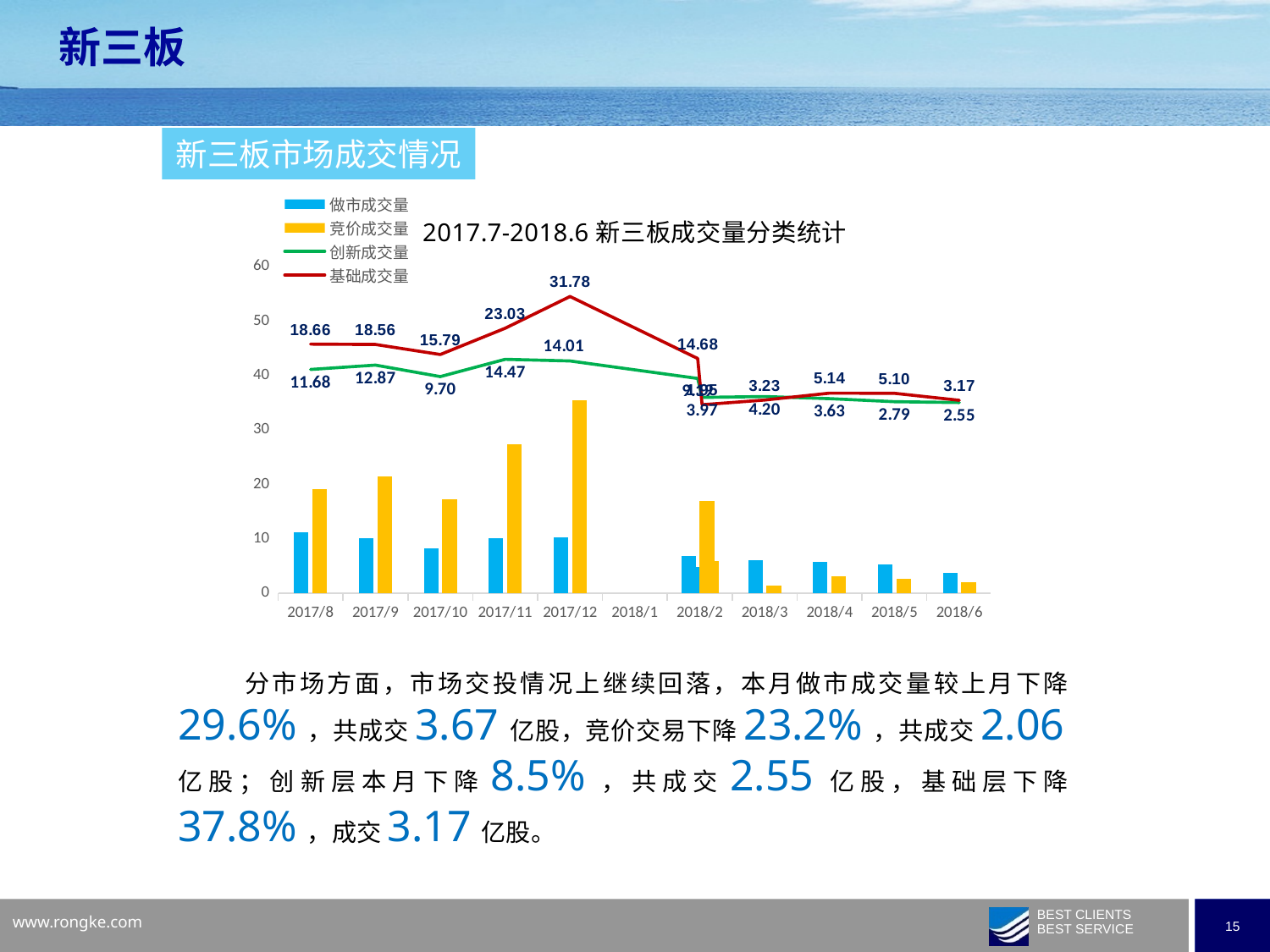
In which month does 基础成交量 reach its highest value? 2017/12 What is the difference between 基础成交量 in 2017/12 and in 2017/11? 8.75 Is the 竞价成交量 bar for 2017/12 greater or less than 30? greater How many categories are shown on the x axis of the chart? 11 What is the value of 创新成交量 for 2017/11? 14.47 How many series does the chart legend list? 4 What kind of chart is shown on the slide? A combined bar and line chart What is the value of 基础成交量 for 2018/6? 3.17 For 2017/8, which is larger: 基础成交量 or 创新成交量? 基础成交量 In which month does 创新成交量 have its lowest labelled value? 2018/6 What is the title of the chart? 2017.7-2018.6 新三板成交量分类统计 What is the value of 基础成交量 for 2017/12? 31.78